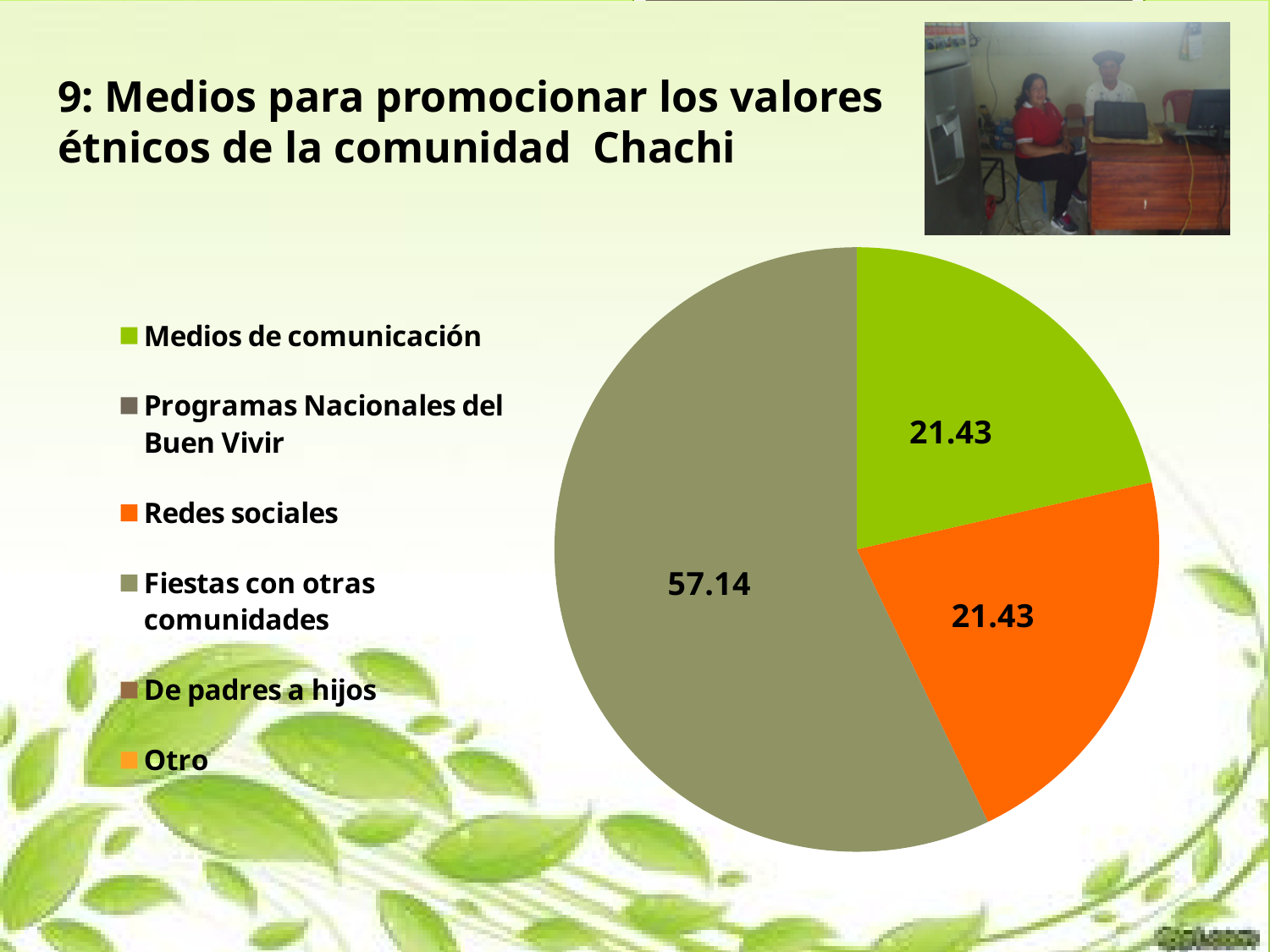
What is the value shown for Fiestas con otras comunidades? 57.14 What colour is the slice for Redes sociales? orange How many slices are visible in the pie chart? 3 What type of chart is shown on the slide? pie chart Which is larger, the slice for Fiestas con otras comunidades or the slice for Medios de comunicación? Fiestas con otras comunidades What is the value shown for Medios de comunicación? 21.43 Which category has the largest slice of the pie? Fiestas con otras comunidades What is the title of the slide containing the chart? 9: Medios para promocionar los valores étnicos de la comunidad Chachi How many entries does the legend list? 6 What is the value shown for Redes sociales? 21.43 What share of the pie does Fiestas con otras comunidades represent? 57.14 What is the difference between the value for Fiestas con otras comunidades and the value for Redes sociales? 35.71